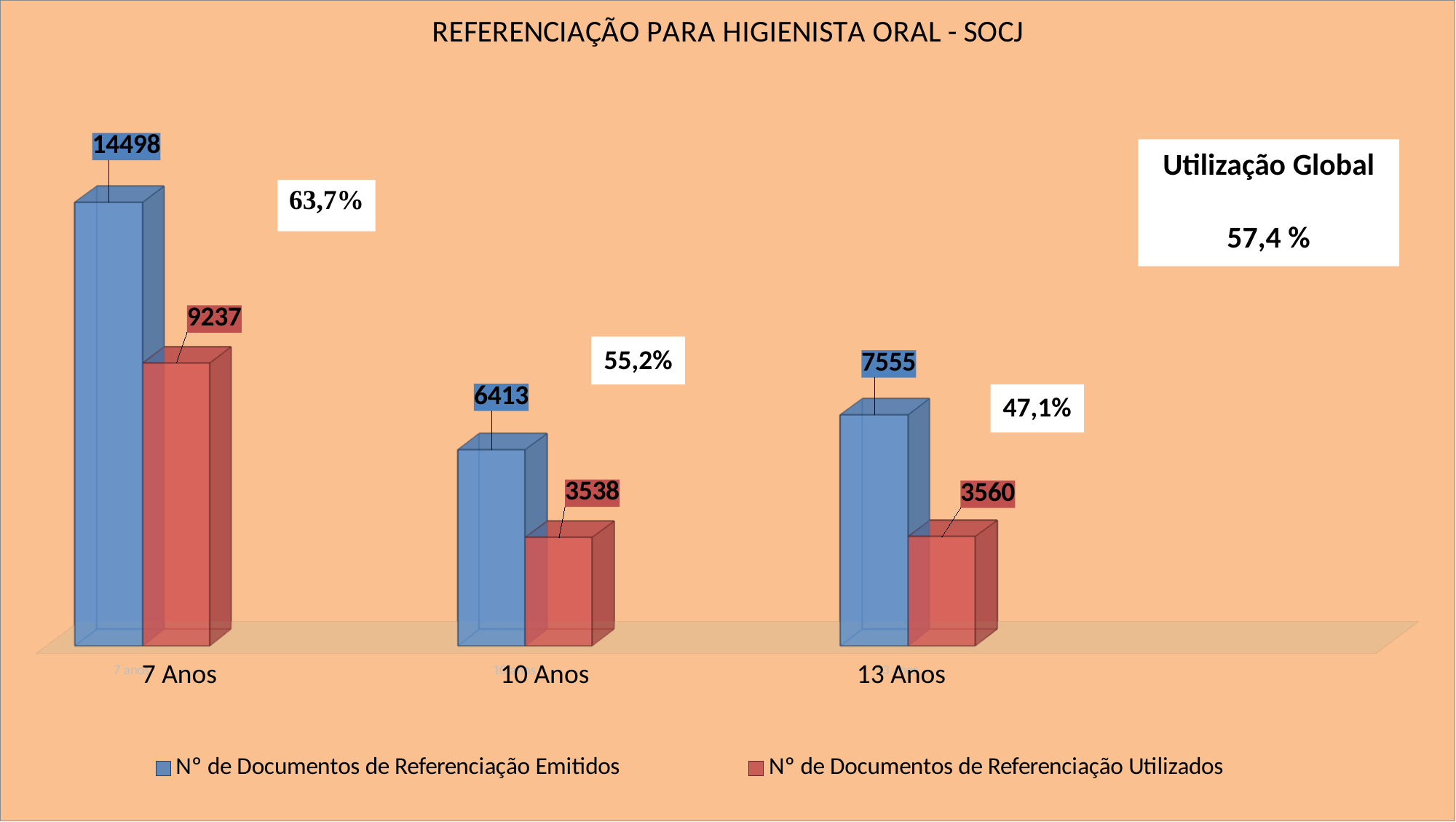
How many age groups are shown on the x axis? 3 What kind of chart is shown? bar chart What is the number of Documentos de Referenciação Utilizados for 10 Anos? 3538 How many series does the legend list? 2 Which age group has the highest number of Documentos de Referenciação Emitidos? 7 Anos What is the number of Documentos de Referenciação Emitidos for 7 Anos? 14498 Which age group has the lowest number of Documentos de Referenciação Utilizados? 10 Anos What is the number of Documentos de Referenciação Emitidos for 13 Anos? 7555 What is the difference between Documentos de Referenciação Emitidos and Utilizados for 10 Anos? 2875 Which is larger: Documentos de Referenciação Emitidos for 10 Anos or for 13 Anos? 13 Anos What is the number of Documentos de Referenciação Utilizados for 7 Anos? 9237 What is the Utilização Global percentage shown on the slide? 57,4 %